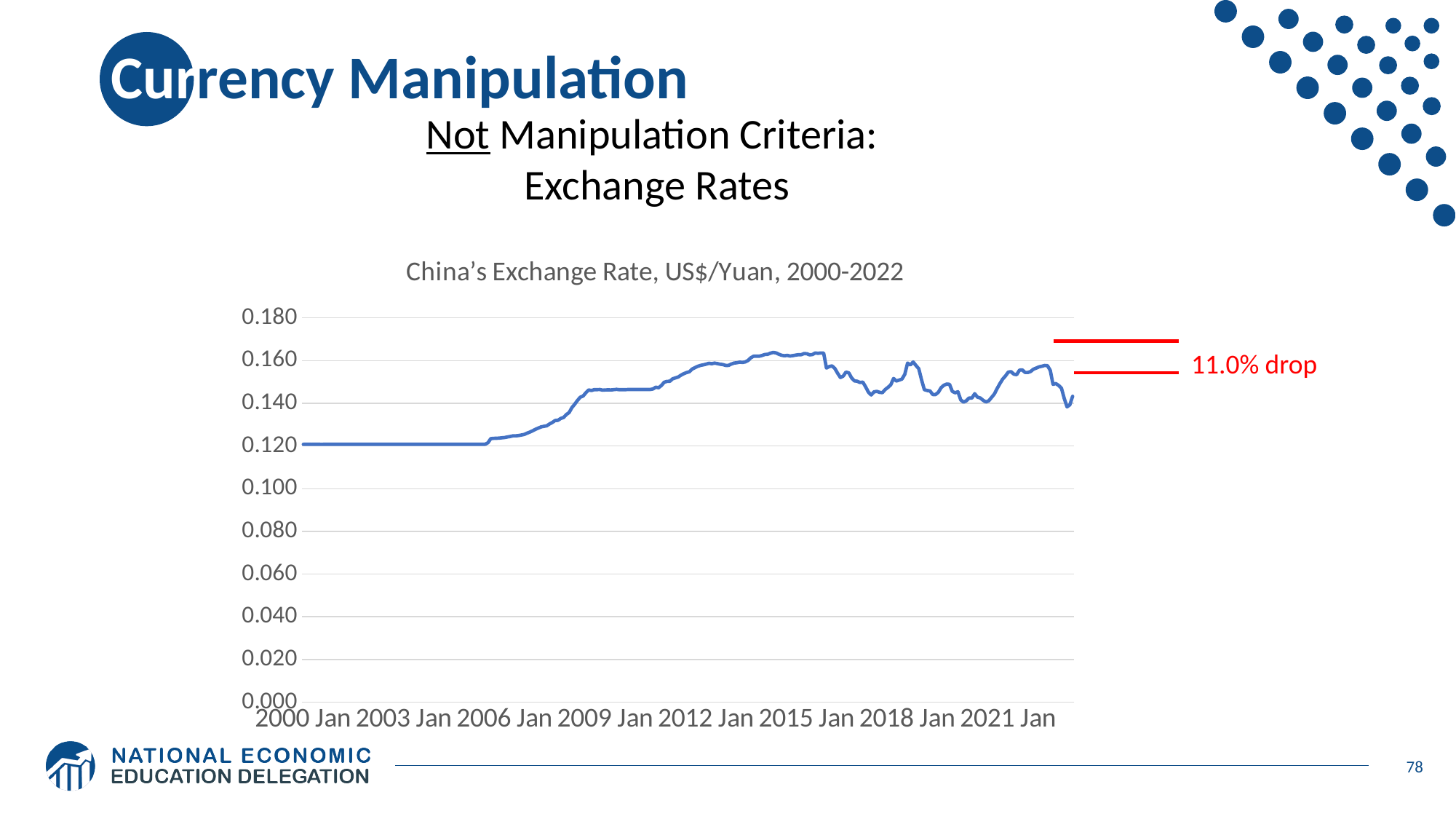
Is the exchange rate in 2015 Jan greater or less than 0.140? greater Which is higher, the exchange rate in 2009 Jan or in 2003 Jan? 2009 Jan What percentage drop is annotated in red on the chart? 11.0% drop What is the title of the chart? China's Exchange Rate, US$/Yuan, 2000-2022 Is the exchange rate in 2021 Jan greater or less than 0.160? less Does the exchange rate rise or fall between 2006 Jan and 2009 Jan? rise How many year labels are shown on the x axis? 8 What is the highest value shown on the y axis? 0.180 Does the exchange rate rise or fall between 2015 Jan and the end of the series in 2022? fall What kind of chart is shown on the slide? line chart Is the exchange rate in 2000 Jan greater or less than 0.100? greater